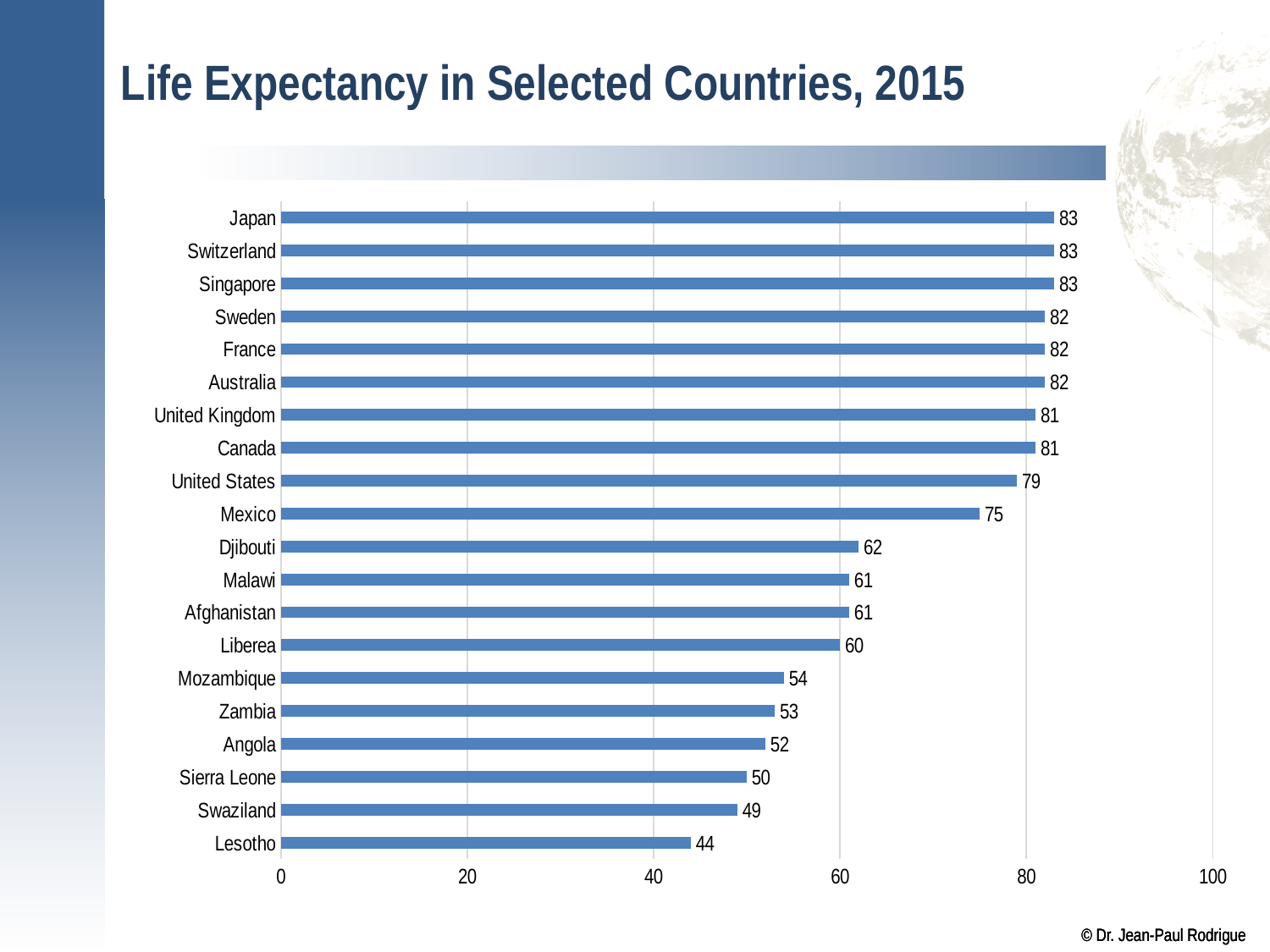
Which has a higher life expectancy value, Zambia or Swaziland? Zambia What is the title of the chart? Life Expectancy in Selected Countries, 2015 Which country has the lowest life expectancy on the chart? Lesotho Which has a higher life expectancy value, Canada or Mexico? Canada What is the life expectancy value shown for Lesotho? 44 What is the life expectancy value shown for the United States? 79 How many countries are shown on the chart? 20 What kind of chart is shown on the slide? Bar chart What is the life expectancy value shown for Mexico? 75 What is the difference between the life expectancy values for Japan and Lesotho? 39 Is the value for Mozambique greater or less than 60? less What is the difference between the life expectancy values for Mexico and Djibouti? 13